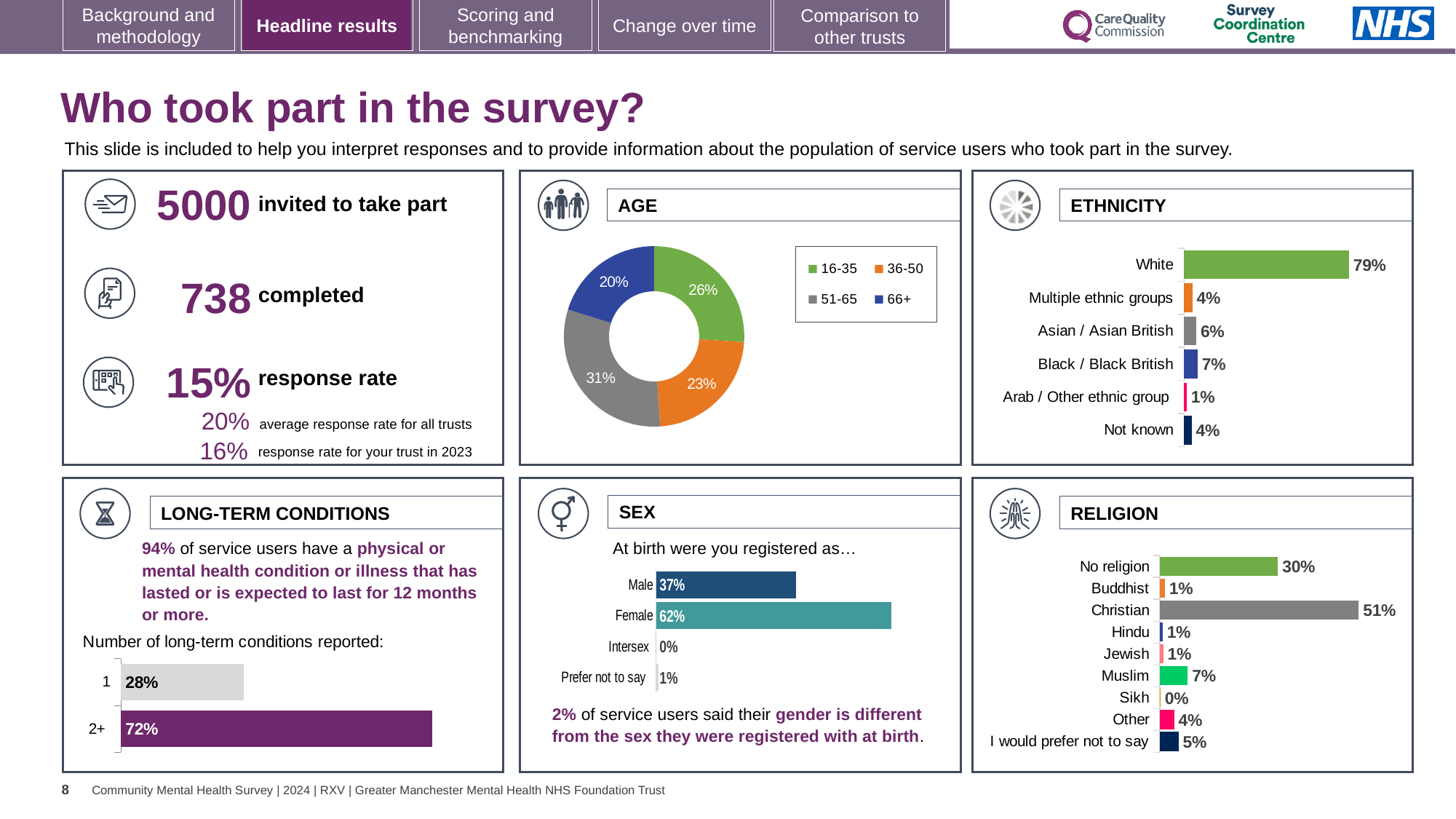
In the ETHNICITY chart, how many categories are shown? 6 In the SEX chart, what percentage were registered as Female at birth? 62% In the AGE chart, how many age groups does the legend list? 4 What kind of chart is the AGE chart? Donut chart In the RELIGION chart, what is the difference between Christian and No religion? 21% In the AGE chart, what percentage of respondents were aged 51-65? 31% In the ETHNICITY chart, what is the value for Black / Black British? 7% In the ETHNICITY chart, which category has the highest value? White In the SEX chart, which is larger, Male or Female? Female In the RELIGION chart, which category has the highest value? Christian In the ETHNICITY chart, what is the difference between White and Asian / Asian British? 73% In the LONG-TERM CONDITIONS chart, what percentage reported 2+ conditions? 72%